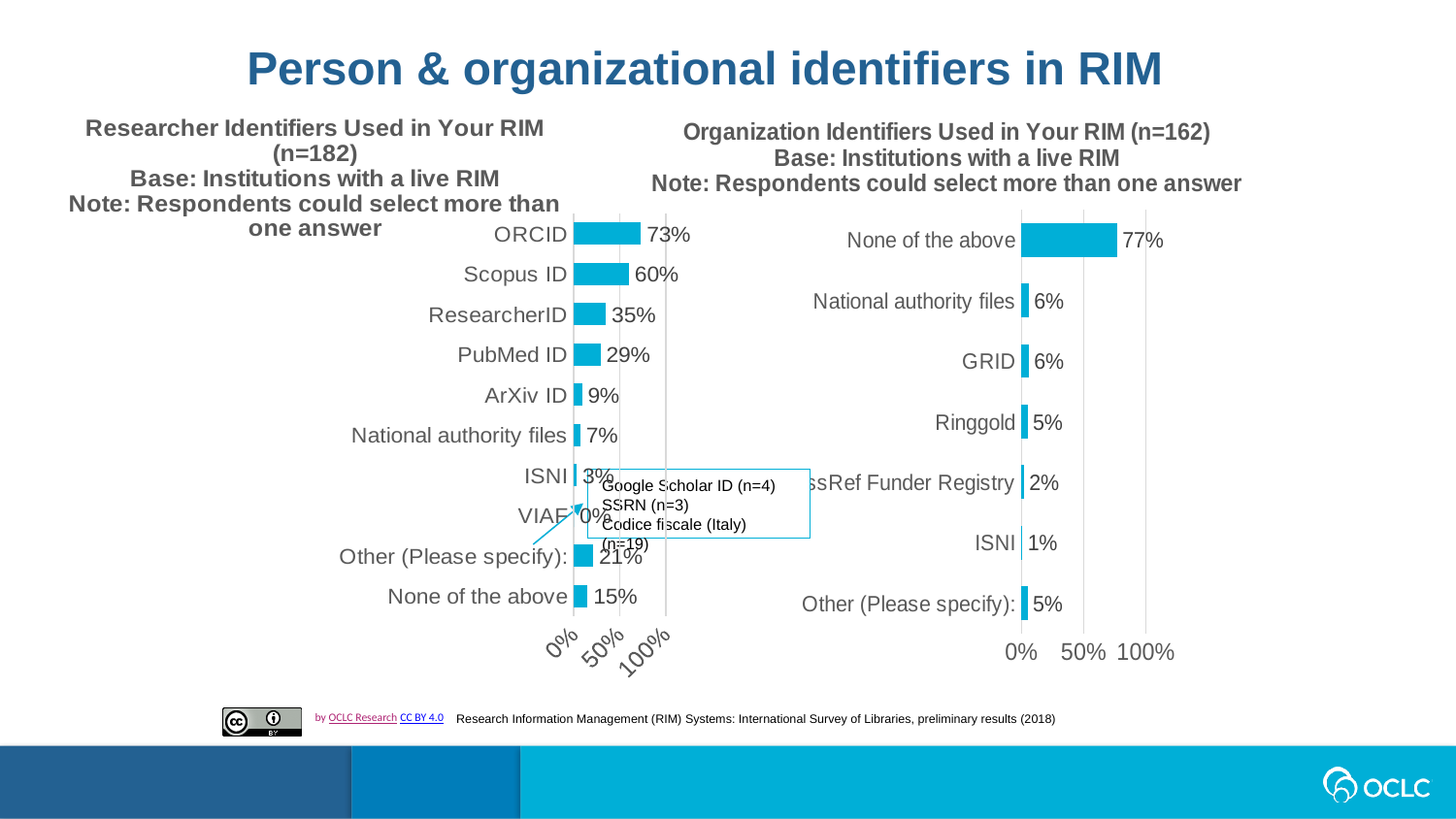
In the Researcher Identifiers chart, what is the difference between the percentages for ORCID and Scopus ID? 13% In the Researcher Identifiers chart, which identifier has the lowest percentage? VIAF In the Researcher Identifiers chart, what percentage is shown for Scopus ID? 60% In the Researcher Identifiers chart, which is larger: PubMed ID or ArXiv ID? PubMed ID How many categories are shown in the Researcher Identifiers chart? 10 In the Researcher Identifiers chart, what percentage is shown for ORCID? 73% What type of chart is the Organization Identifiers chart? Bar chart In the Organization Identifiers chart, what is the difference between None of the above and GRID? 71% In the Organization Identifiers chart, what percentage is shown for Ringgold? 5% In the Organization Identifiers chart, what percentage is shown for None of the above? 77% In the Organization Identifiers chart, which category has the lowest percentage? ISNI In the Researcher Identifiers chart, which identifier has the highest percentage? ORCID